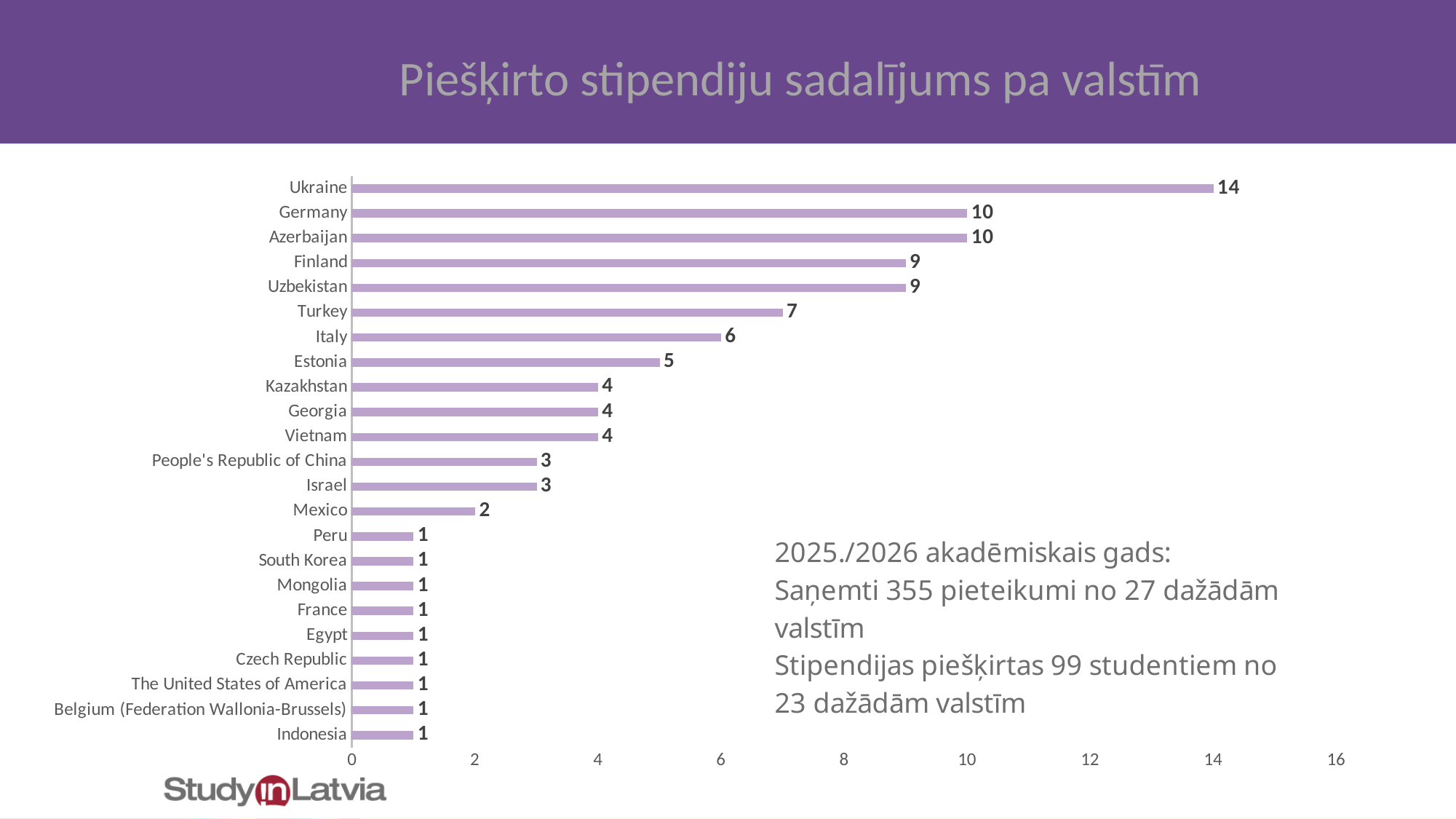
What is the value for Mexico? 2 What is the value for Finland? 9 What is the value for Ukraine? 14 What is the difference between the values for Ukraine and Germany? 4 What is the title of the slide? Piešķirto stipendiju sadalījums pa valstīm What kind of chart is shown on the slide? bar chart What is the difference between the values for Turkey and Italy? 1 Which country has the highest value? Ukraine Which has a larger value, Uzbekistan or Kazakhstan? Uzbekistan What is the value for Estonia? 5 Is the value for Azerbaijan greater or less than 8? greater How many countries are shown in the chart? 23